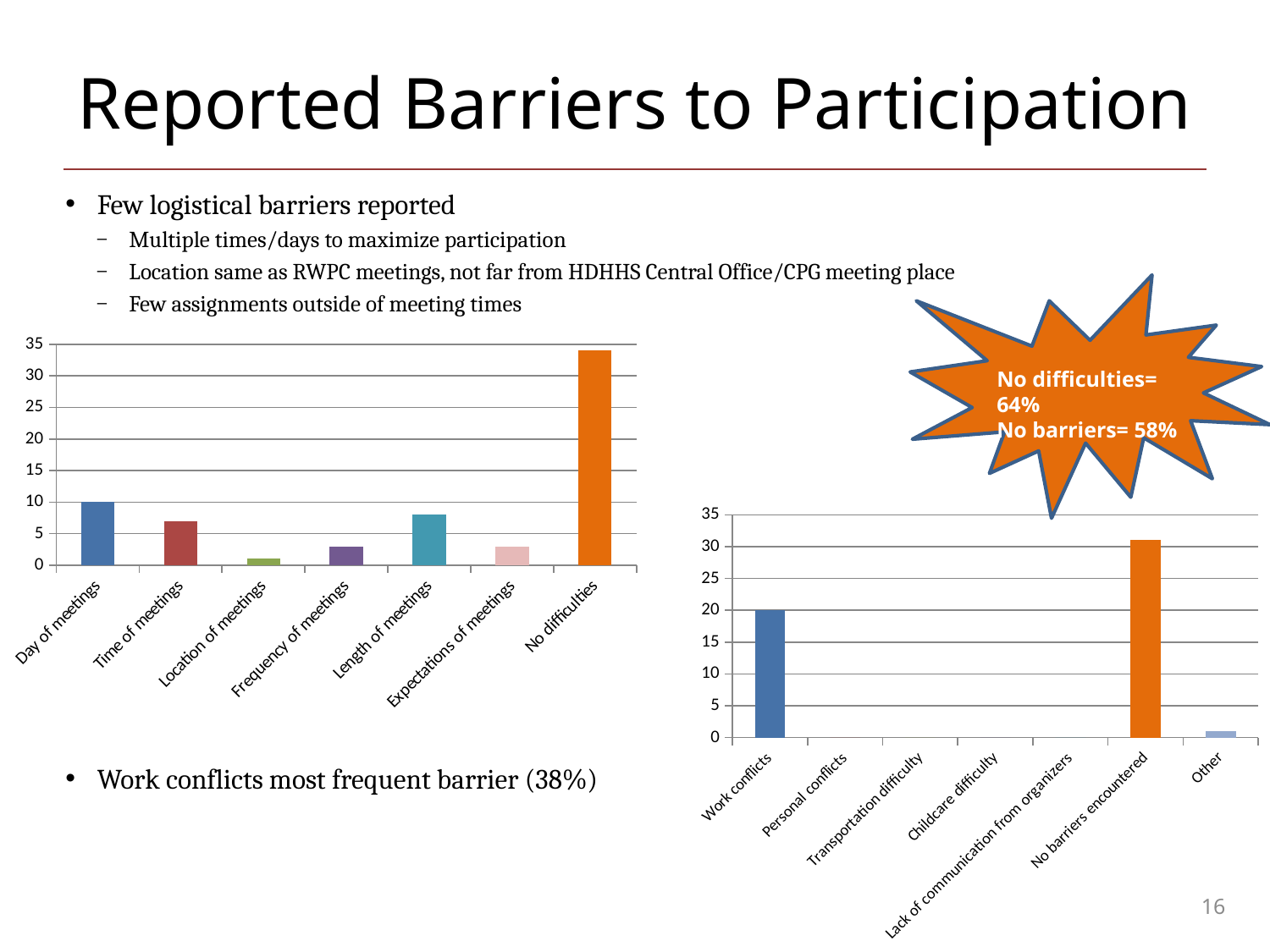
In the chart on the left of the slide, which is larger: Day of meetings or Time of meetings? Day of meetings In the chart on the left of the slide, is the value for No difficulties greater or less than 30? greater In the chart on the left of the slide, how many categories are shown on the x axis? 7 In the chart on the right of the slide, how many categories are shown on the x axis? 7 In the chart on the left of the slide, which category has the lowest value? Location of meetings In the chart on the right of the slide, what is the value for Work conflicts? 20 In the chart on the right of the slide, which is larger: Work conflicts or Other? Work conflicts In the chart on the right of the slide, which category has the highest value? No barriers encountered In the chart on the left of the slide, which category has the highest value? No difficulties In the chart on the right of the slide, is the value for No barriers encountered greater or less than 25? greater What kind of chart is the chart on the left of the slide? bar chart In the chart on the left of the slide, is the value for Length of meetings greater or less than 10? less